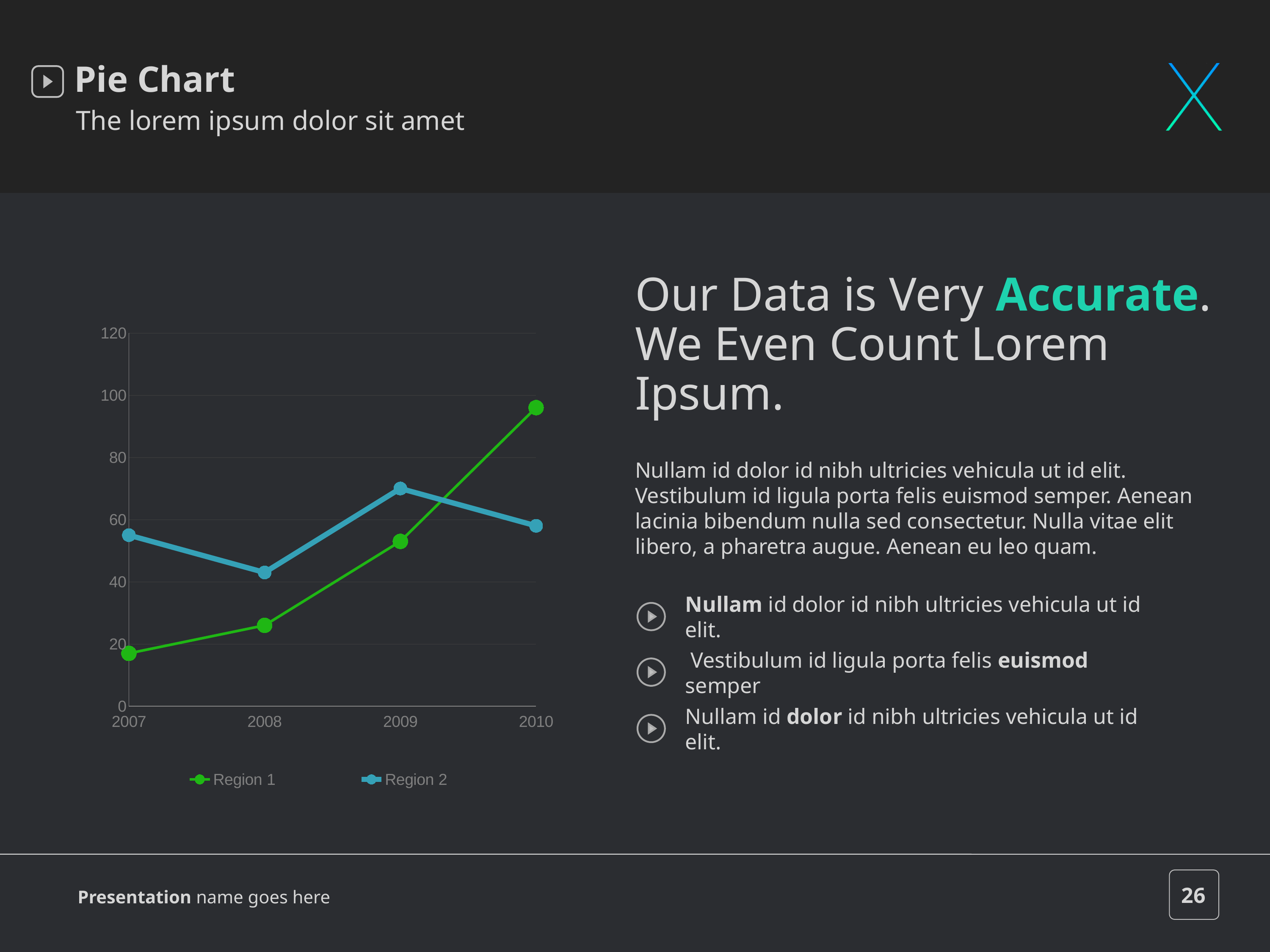
Is the value for Region 1 in 2010 greater or less than 80? greater In which year does Region 1 reach its highest value? 2010 In 2007, which series has the larger value, Region 1 or Region 2? Region 2 What kind of chart is shown on the slide? line chart Is the value for Region 2 in 2008 greater or less than 60? less How many years are shown on the x axis of the chart? 4 In which year does Region 2 have its lowest value? 2008 In which year does Region 2 reach its highest value? 2009 What are the two series names listed in the chart's legend? Region 1 and Region 2 Does the Region 1 line rise or fall from 2007 to 2010? rises How many series does the chart's legend list? 2 In which year does Region 1 have its lowest value? 2007